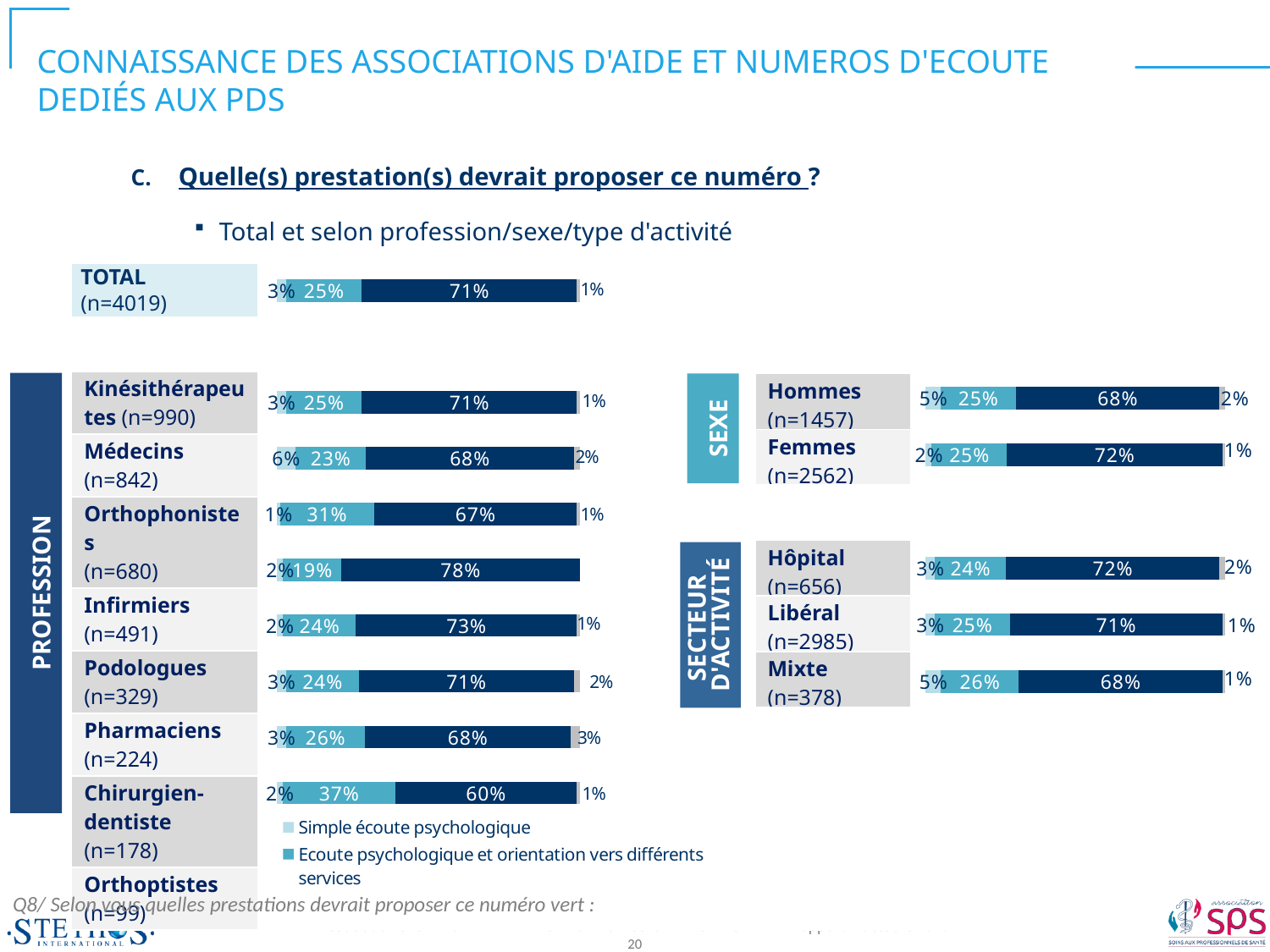
In the PROFESSION chart, what percentage of Kinésithérapeutes chose 'Ecoute psychologique et orientation vers différents services'? 25% How many categories are shown in the SECTEUR D'ACTIVITÉ chart? 3 In the TOTAL chart, what percentage is shown for the 'Ecoute psychologique et orientation vers différents services' segment? 25% In the SEXE chart, which group has the larger share for 'Ecoute psychologique et orientation vers différents services', Hommes or Femmes? Neither; both are 25% In the SEXE chart, what percentage of Hommes chose 'Ecoute psychologique et orientation vers différents services'? 25% In the SEXE chart, what percentage of Femmes chose 'Ecoute psychologique et orientation vers différents services'? 25% In the SEXE chart, what is the difference in percentage points between Femmes and Hommes for 'Ecoute psychologique et orientation vers différents services'? 0 percentage points What type of chart is used on this slide to show the results? Bar chart In the PROFESSION chart, what percentage of Médecins chose 'Simple écoute psychologique'? 6% In the SECTEUR D'ACTIVITÉ chart, which category has the lowest share for 'Ecoute psychologique et orientation vers différents services'? Hôpital In the TOTAL chart, what percentage is shown for the 'Simple écoute psychologique' segment? 3% In the SECTEUR D'ACTIVITÉ chart, which category has the highest share for 'Ecoute psychologique et orientation vers différents services'? Mixte